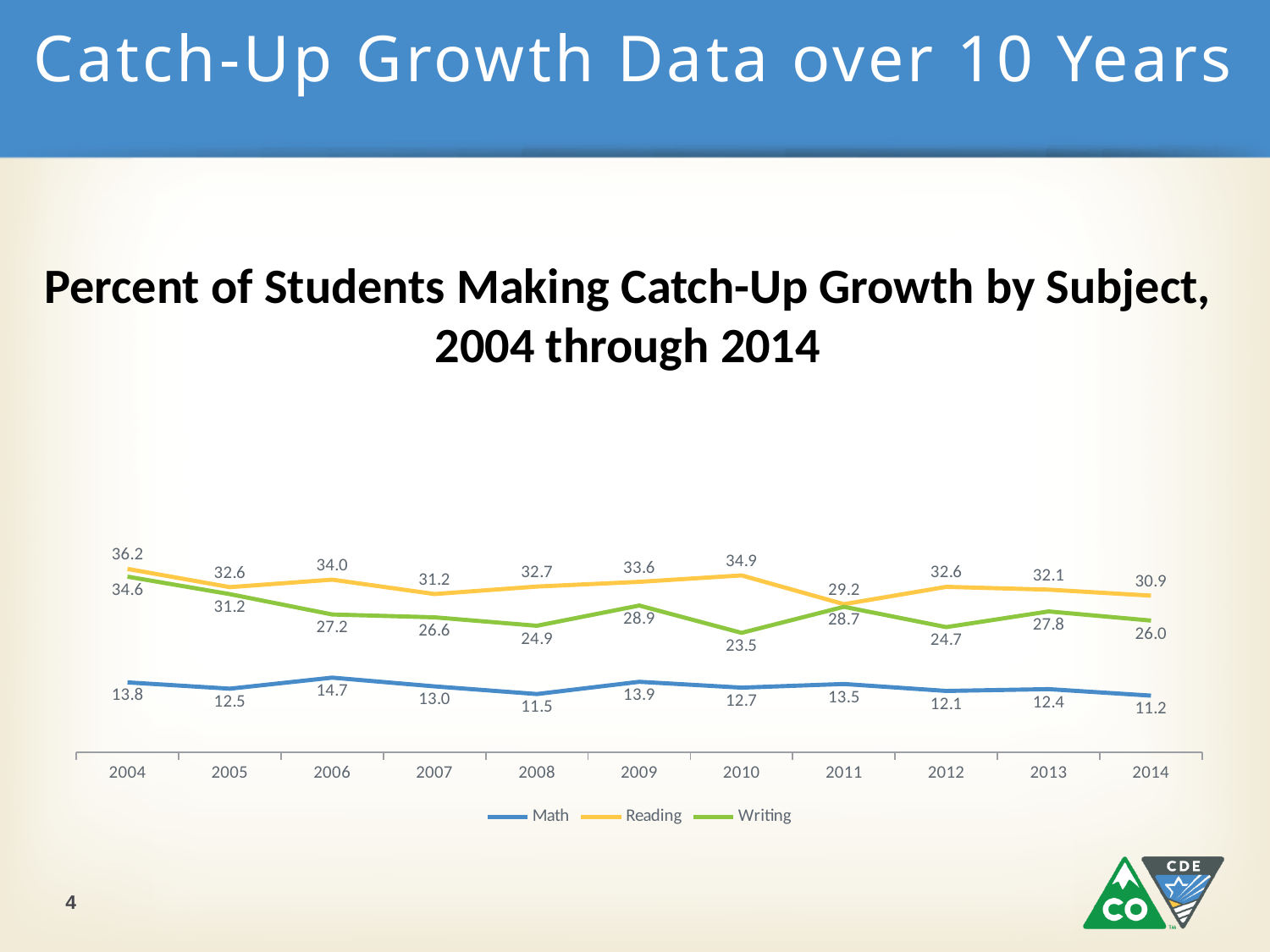
In which year is the Math value lowest? 2014 What is the Reading value for 2004? 36.2 Does the Writing value rise or fall from 2004 to 2008? Fall What is the difference between the Reading and Writing values in 2014? 4.9 How many years are plotted along the x axis? 11 In which year is the Reading value highest? 2004 What is the Math value for 2008? 11.5 Which is larger, the Math value for 2006 or for 2005? 2006 How many series does the legend list? 3 What is the Writing value for 2010? 23.5 What kind of chart is shown on the slide? Line chart What is the title of the chart? Percent of Students Making Catch-Up Growth by Subject, 2004 through 2014